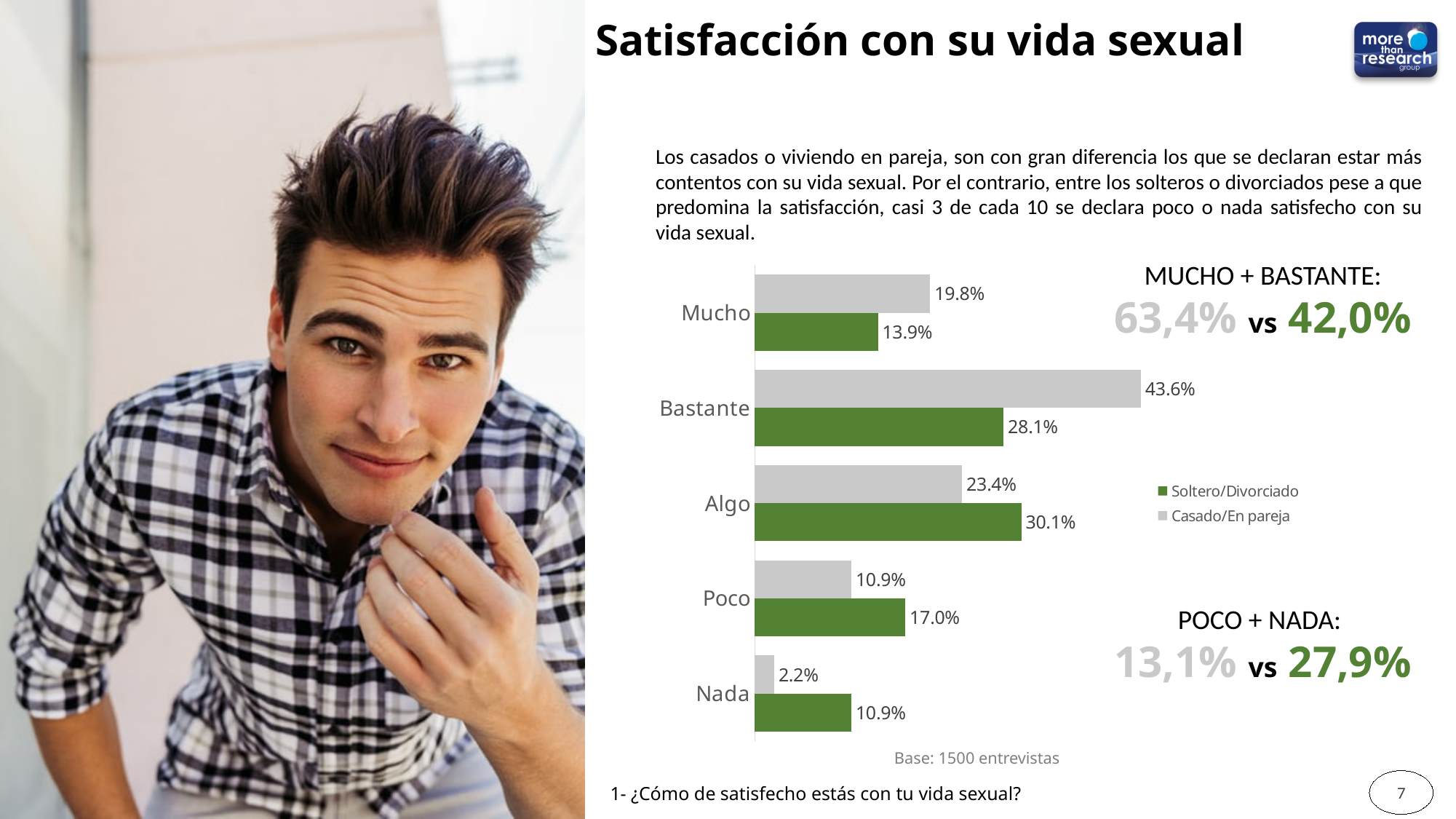
Which colour represents the Soltero/Divorciado series in the chart? Green How many series does the legend list? 2 What is the difference between Casado/En pareja and Soltero/Divorciado in the Bastante category? 15.5% What kind of chart is shown on the slide? Bar chart How many categories are shown on the chart? 5 Which category has the highest value for Casado/En pareja? Bastante In the Mucho category, which series has the larger value, Soltero/Divorciado or Casado/En pareja? Casado/En pareja What is the value for Soltero/Divorciado in the Poco category? 17.0% What is the value for Casado/En pareja in the Nada category? 2.2% What is the value for Casado/En pareja in the Bastante category? 43.6% What is the value for Soltero/Divorciado in the Algo category? 30.1%